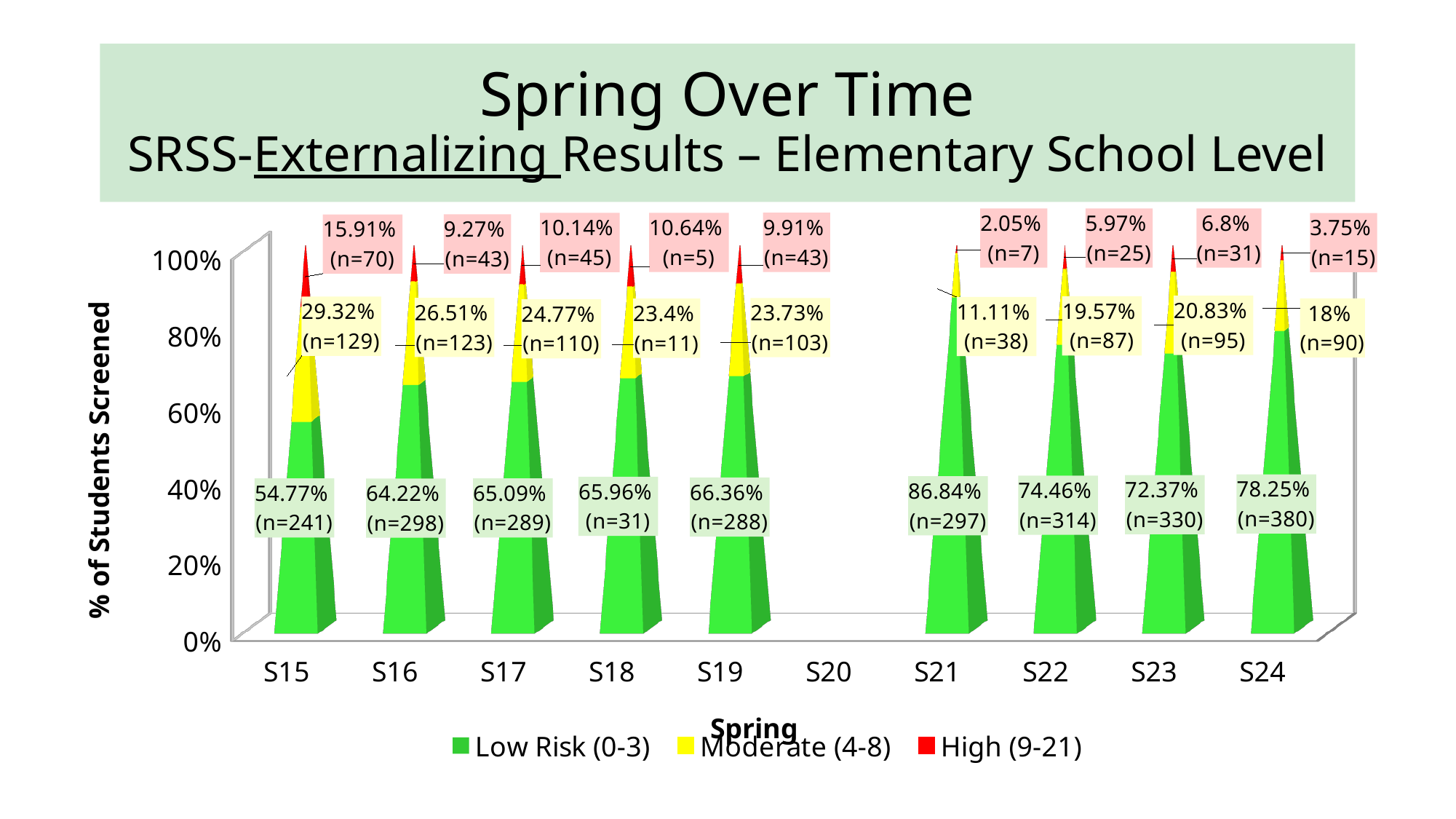
Does the Low Risk (0-3) percentage rise or fall from S15 to S19? Rise Which spring has the lowest High (9-21) percentage? S21 What is the High (9-21) percentage for S15? 15.91% What kind of chart is shown? Stacked bar chart How many students were in the Low Risk (0-3) group in S24? n=380 How many series does the legend list? 3 Which spring has the highest Low Risk (0-3) percentage? S21 What is the Low Risk (0-3) percentage for S21? 86.84% Which spring has the lowest Low Risk (0-3) percentage? S15 What is the difference in Low Risk (0-3) percentage between S24 and S15? 23.48 percentage points What is the Moderate (4-8) percentage for S24? 18% Which has a larger Moderate (4-8) percentage, S16 or S17? S16